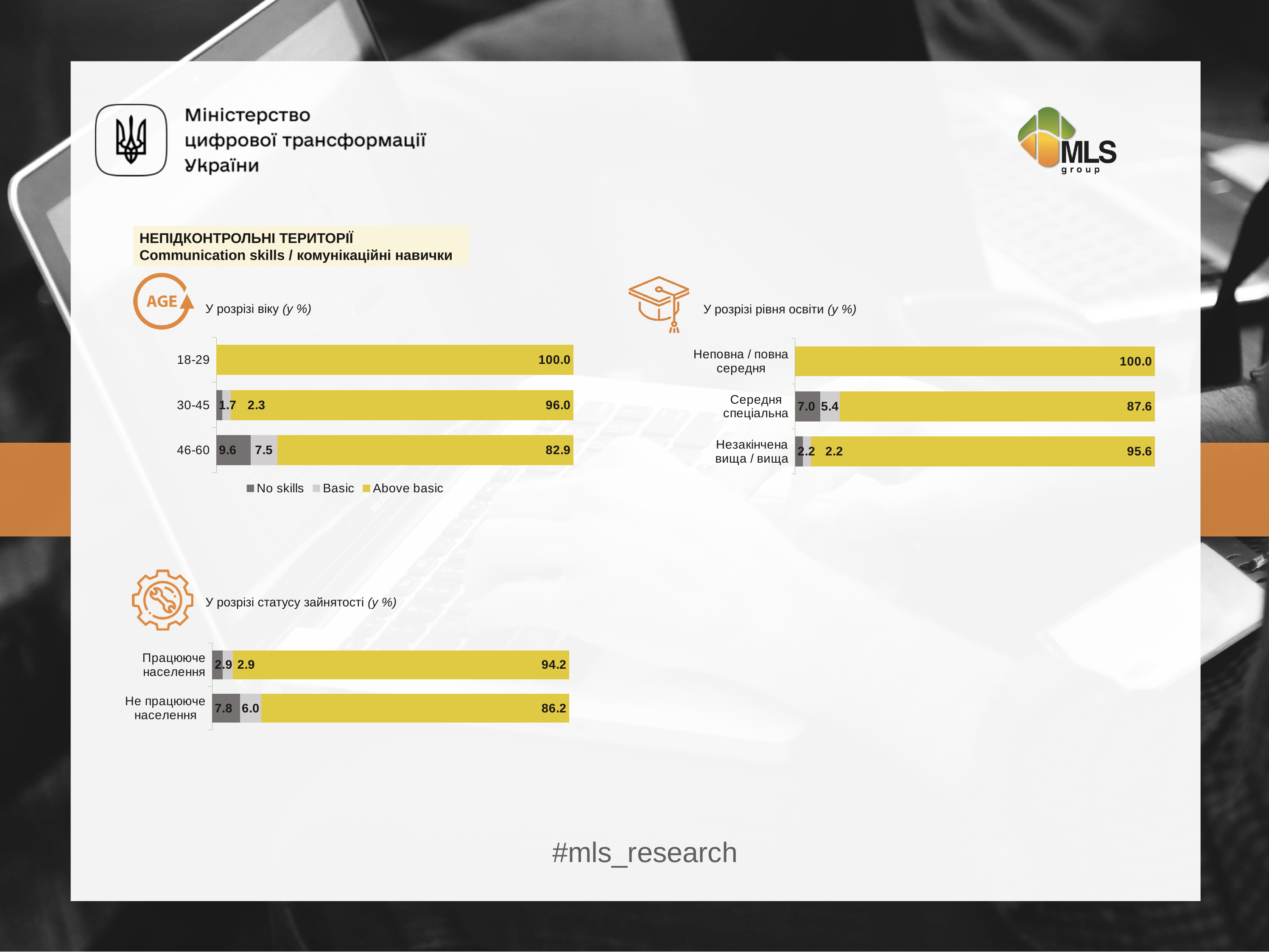
In the education chart (top right), how many education categories are shown? 3 In the age chart (top left), what is the No skills value for the 30-45 group? 1.7 In the education chart (top right), what is the No skills value for Середня спеціальна? 7.0 In the age chart (top left), what is the Above basic value for the 46-60 group? 82.9 In the age chart (top left), how many series does the legend list? 3 In the employment status chart (bottom left), what is the Above basic value for Не працююче населення? 86.2 In the employment status chart (bottom left), which group has the larger Above basic value, Працююче населення or Не працююче населення? Працююче населення In the age chart (top left), what is the difference between the Above basic values for 30-45 and 46-60? 13.1 In the age chart (top left), which age group has the highest Above basic value? 18-29 In the age chart (top left), what kind of chart is shown? Stacked bar chart In the education chart (top right), what is the Above basic value for Середня спеціальна? 87.6 In the education chart (top right), which education level has the lowest Above basic value? Середня спеціальна